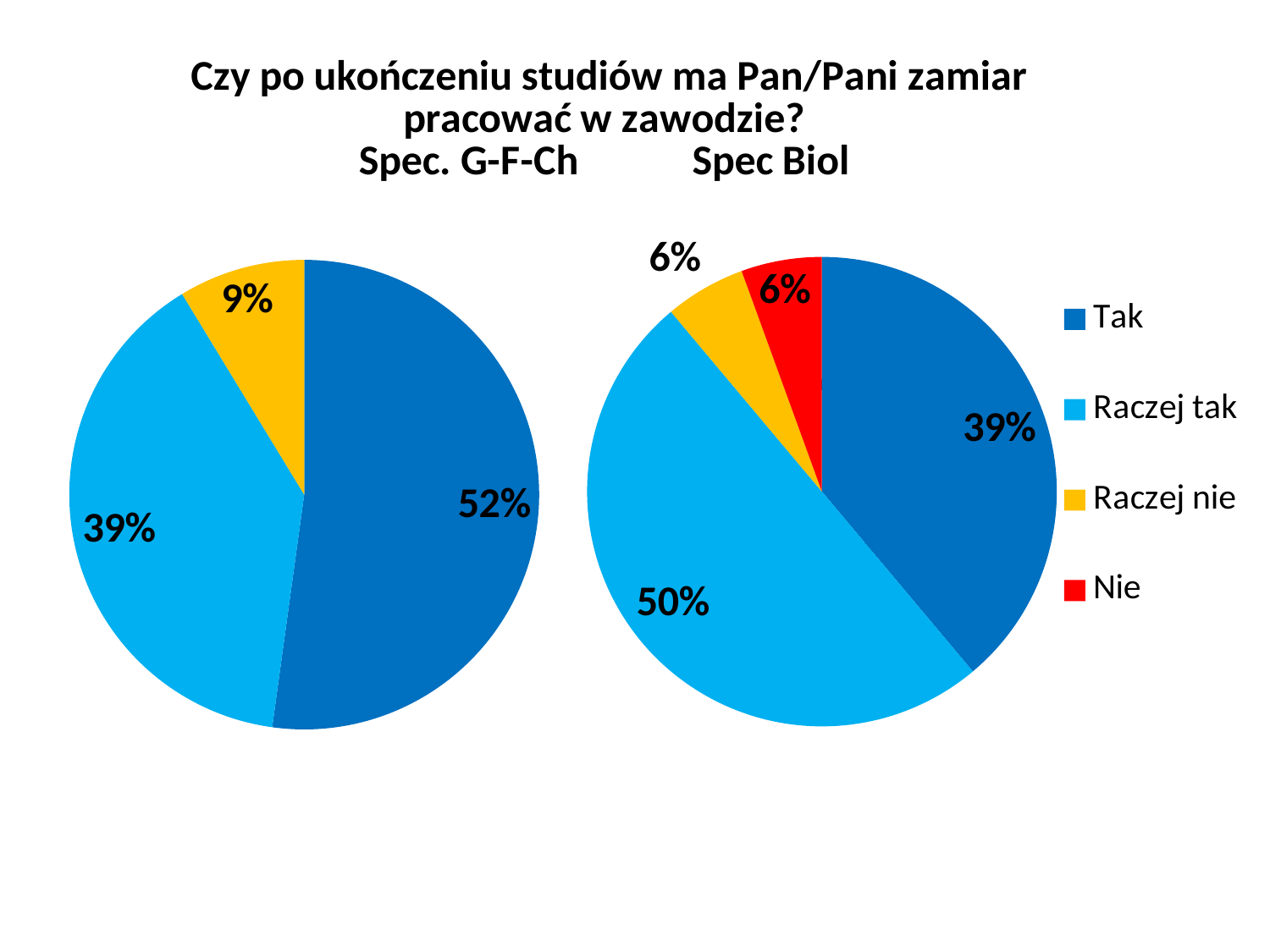
In the Spec. G-F-Ch pie chart, what share is labelled for the Raczej nie slice? 9% How many entries does the legend list? 4 Which is larger in the Spec Biol pie chart: the Tak slice or the Raczej tak slice? Raczej tak In the Spec Biol pie chart, what share is labelled for the Nie slice? 6% How many slices does the Spec Biol pie chart have? 4 In the Spec. G-F-Ch pie chart, what share is labelled for the Tak slice? 52% What kind of chart is used for Spec. G-F-Ch? Pie chart In the Spec. G-F-Ch pie chart, what is the difference between the Tak and Raczej tak shares? 13% In the Spec. G-F-Ch pie chart, which category has the smallest slice? Raczej nie In the Spec Biol pie chart, what share is labelled for the Raczej tak slice? 50% In the Spec. G-F-Ch pie chart, which category has the largest slice? Tak In the Spec Biol pie chart, which category has the largest slice? Raczej tak